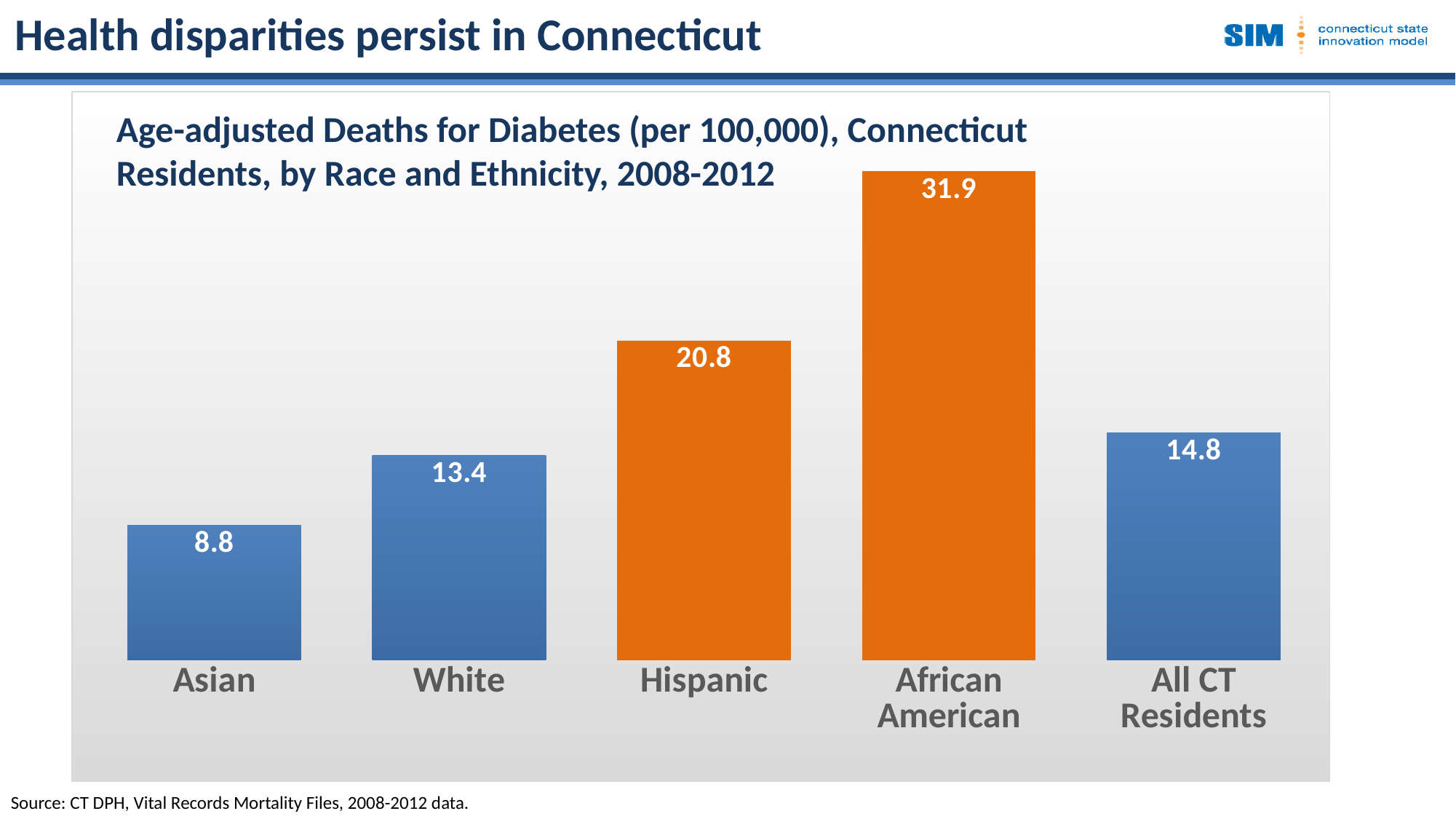
What is the difference between the Hispanic and White diabetes death rates? 7.4 Which groups' bars are coloured orange? Hispanic and African American What is the age-adjusted diabetes death rate for White residents? 13.4 What is the age-adjusted diabetes death rate for Asian residents? 8.8 How many groups are shown in the chart? 5 What is the age-adjusted diabetes death rate for All CT Residents? 14.8 Which group has the highest age-adjusted diabetes death rate? African American Which group has the lowest age-adjusted diabetes death rate? Asian What is the age-adjusted diabetes death rate for Hispanic residents? 20.8 What is the difference between the African American and Asian diabetes death rates? 23.1 What type of chart is shown on the slide? Bar chart Which is larger, the diabetes death rate for White residents or for All CT Residents? All CT Residents